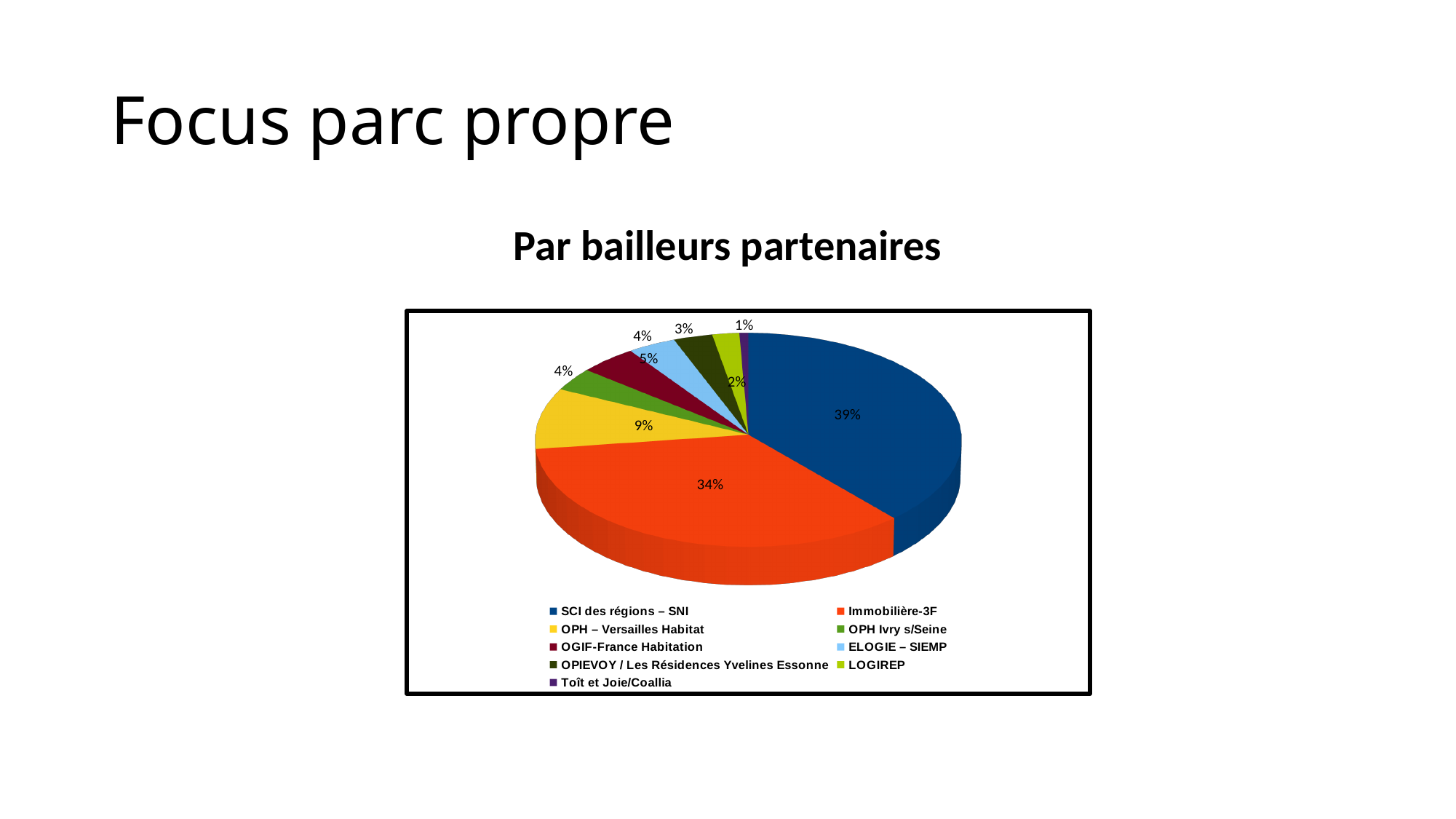
What is the difference in percentage points between SCI des régions – SNI and Immobilière-3F? 5 What type of chart is shown on the slide? Pie chart What percentage is shown for OPH – Versailles Habitat? 9% What percentage is shown for OGIF-France Habitation? 5% What percentage is shown for Toît et Joie/Coallia? 1% What share of the pie does SCI des régions – SNI hold? 39% Which bailleur partenaire has the largest share of the pie? SCI des régions – SNI What is the title of the chart? Par bailleurs partenaires Which is larger, the share for OPH – Versailles Habitat or the share for OGIF-France Habitation? OPH – Versailles Habitat What share of the pie does Immobilière-3F hold? 34% How many slices does the pie chart have? 9 Which bailleur partenaire has the smallest share of the pie? Toît et Joie/Coallia